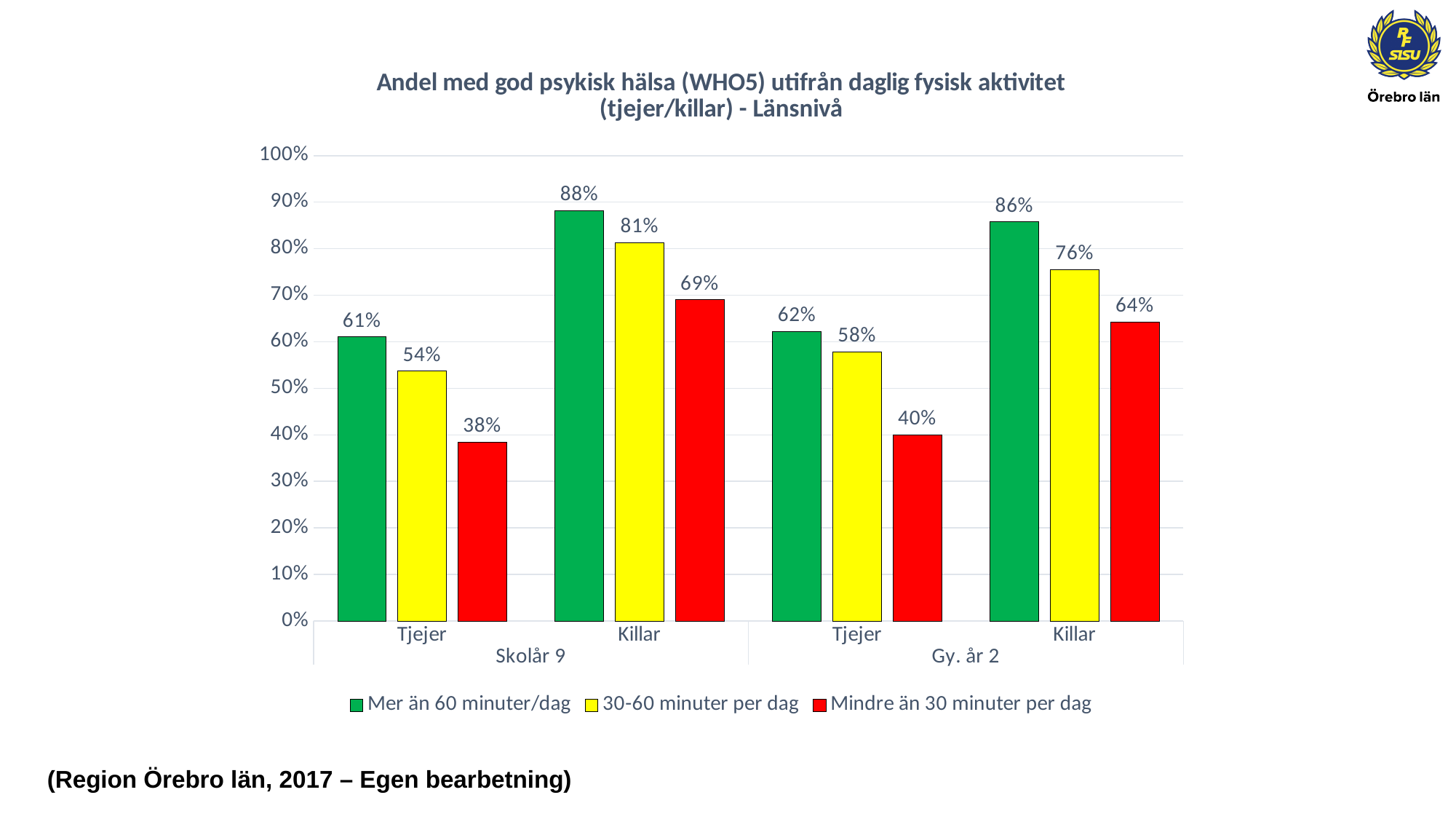
What is the value for Tjejer in Skolår 9 for the series 'Mer än 60 minuter/dag'? 61% What is the value for Tjejer in Gy. år 2 for the series 'Mindre än 30 minuter per dag'? 40% What is the value for Killar in Gy. år 2 for the series '30-60 minuter per dag'? 76% Which colour represents the series 'Mindre än 30 minuter per dag'? Red Which group has the highest value in the series 'Mer än 60 minuter/dag'? Killar, Skolår 9 How many series does the legend list? 3 Is the 'Mindre än 30 minuter per dag' value for Killar in Gy. år 2 greater or less than 60%? greater How many bars are plotted in the chart? 12 Which is larger: the '30-60 minuter per dag' value for Tjejer in Skolår 9 or for Tjejer in Gy. år 2? Tjejer in Gy. år 2 What is the difference between the 'Mer än 60 minuter/dag' and 'Mindre än 30 minuter per dag' values for Killar in Skolår 9? 19% Which group has the lowest value in the series 'Mindre än 30 minuter per dag'? Tjejer, Skolår 9 What kind of chart is shown on the slide? Bar chart